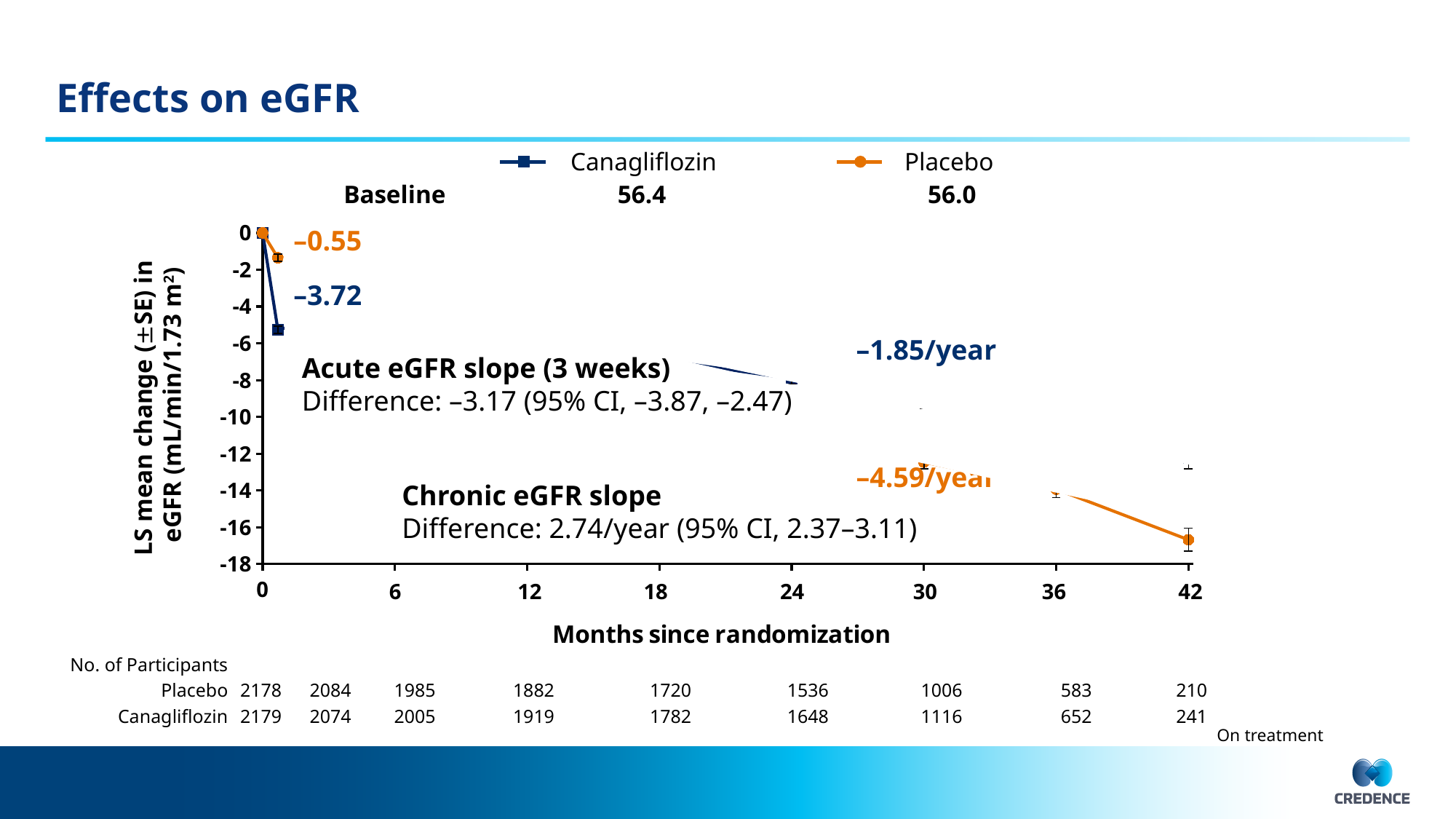
Which series shows the larger acute drop in eGFR, Canagliflozin or Placebo? Canagliflozin What is the stated difference in the acute eGFR slope (3 weeks) between the groups? –3.17 What is the title of the x axis? Months since randomization What is the labelled acute eGFR change for Placebo? –0.55 What is the baseline eGFR value shown for Placebo? 56.0 What is the labelled chronic eGFR slope for Placebo? –4.59/year What are the two series named in the legend? Canagliflozin and Placebo What is the labelled acute eGFR change for Canagliflozin? –3.72 Is the Placebo value at 42 months greater or less than -14? less What is the labelled chronic eGFR slope for Canagliflozin? –1.85/year What kind of chart is shown on the slide? line chart How many series does the legend list? 2